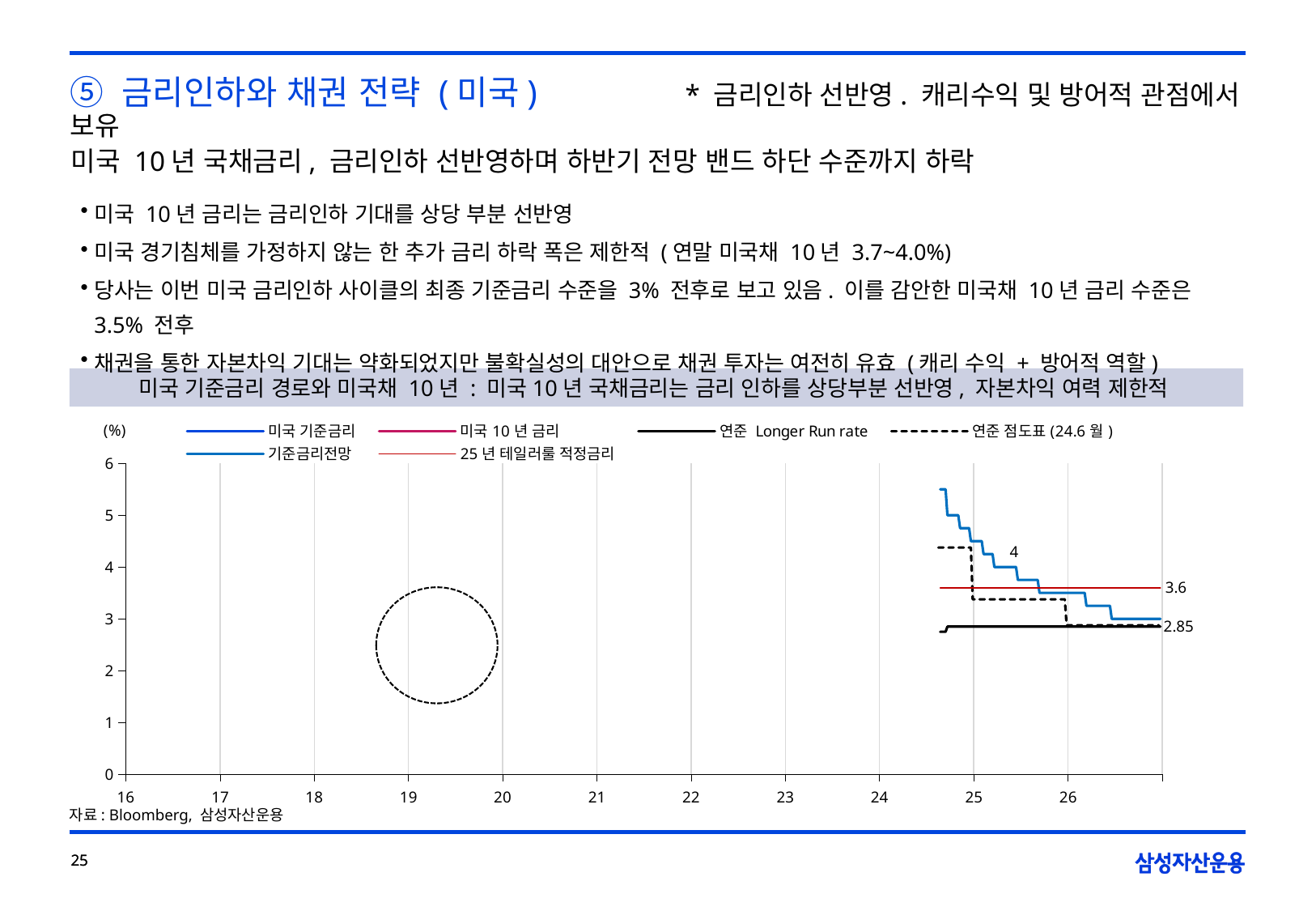
What is the difference between the labelled 25년 테일러룰 적정금리 value (3.6) and the labelled 연준 Longer Run rate value (2.85)? 0.75 What source is cited below the chart? Bloomberg, 삼성자산운용 What kind of chart is shown on the slide? line chart Is the starting value of the 기준금리전망 line greater or less than 5? greater How many series does the chart's legend list? 6 What value is labelled for the 연준 Longer Run rate line? 2.85 Which is larger, the labelled value of 25년 테일러룰 적정금리 or the labelled value of 연준 Longer Run rate? 25년 테일러룰 적정금리 What value is labelled on the 연준 점도표 (24.6월) line? 4 What is the difference between the labelled 연준 점도표 value (4) and the labelled 25년 테일러룰 적정금리 value (3.6)? 0.4 Does the 기준금리전망 line rise or fall as it moves along the x axis? fall What unit is shown at the top of the y axis? (%) What value is labelled for the 25년 테일러룰 적정금리 line? 3.6